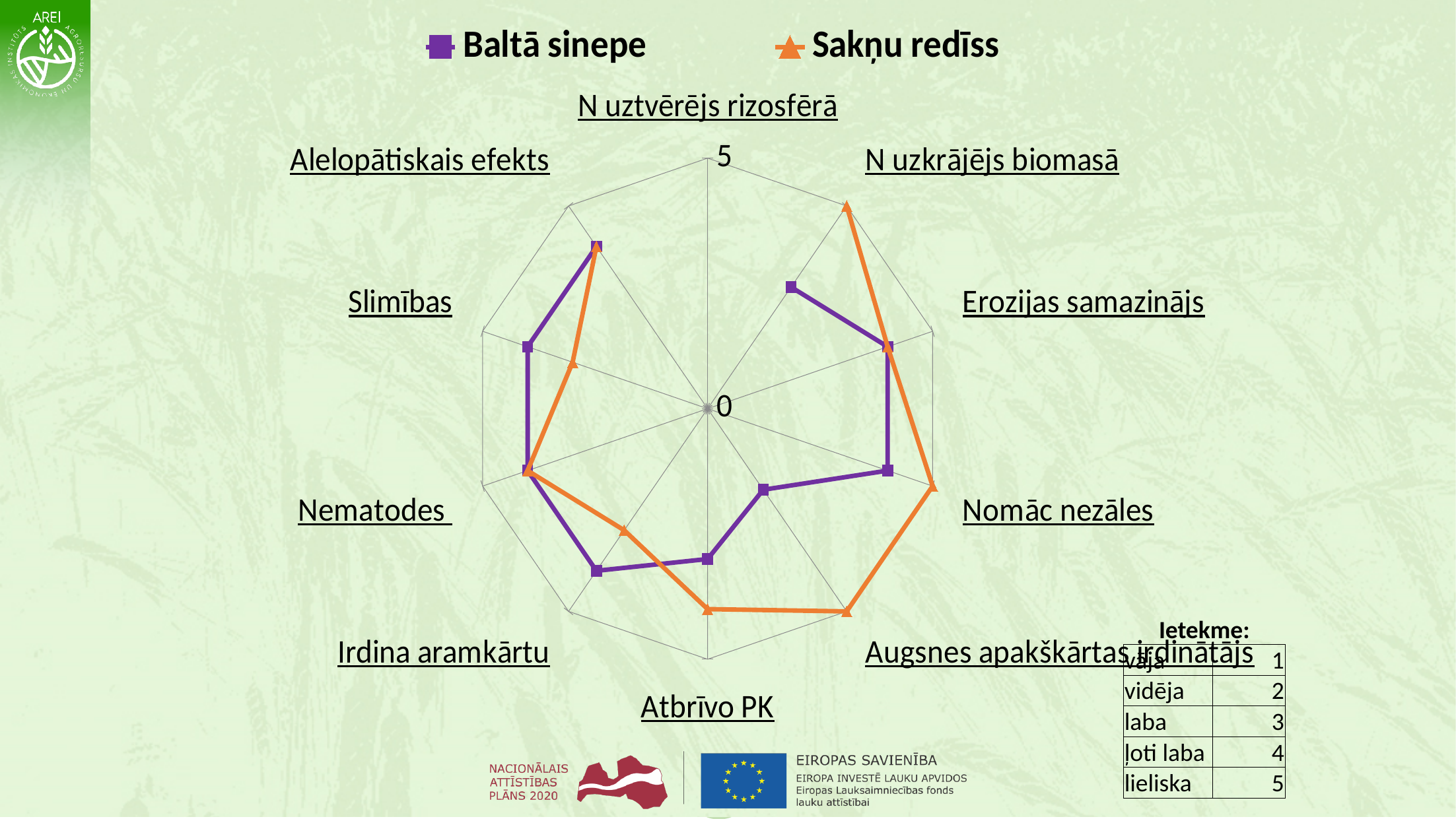
Is the value for Baltā sinepe on the Atbrīvo PK axis greater or less than 5? less What is the value for Sakņu redīss on the Augsnes apakškārtas irdinātājs axis? 5 Which colour represents the Sakņu redīss series in the legend? orange Which series has the larger value on the Slimības axis, Baltā sinepe or Sakņu redīss? Baltā sinepe How many series does the legend list? 2 What is the value for Sakņu redīss on the N uzkrājējs biomasā axis? 5 What is the value for Sakņu redīss on the Nomāc nezāles axis? 5 Which series has the larger value on the Irdina aramkārtu axis, Baltā sinepe or Sakņu redīss? Baltā sinepe What kind of chart is shown on the slide? radar chart What is the maximum value shown on the radar chart's axis scale? 5 Which series has the larger value on the Nomāc nezāles axis, Baltā sinepe or Sakņu redīss? Sakņu redīss How many categories (axes) does the radar chart have? 10